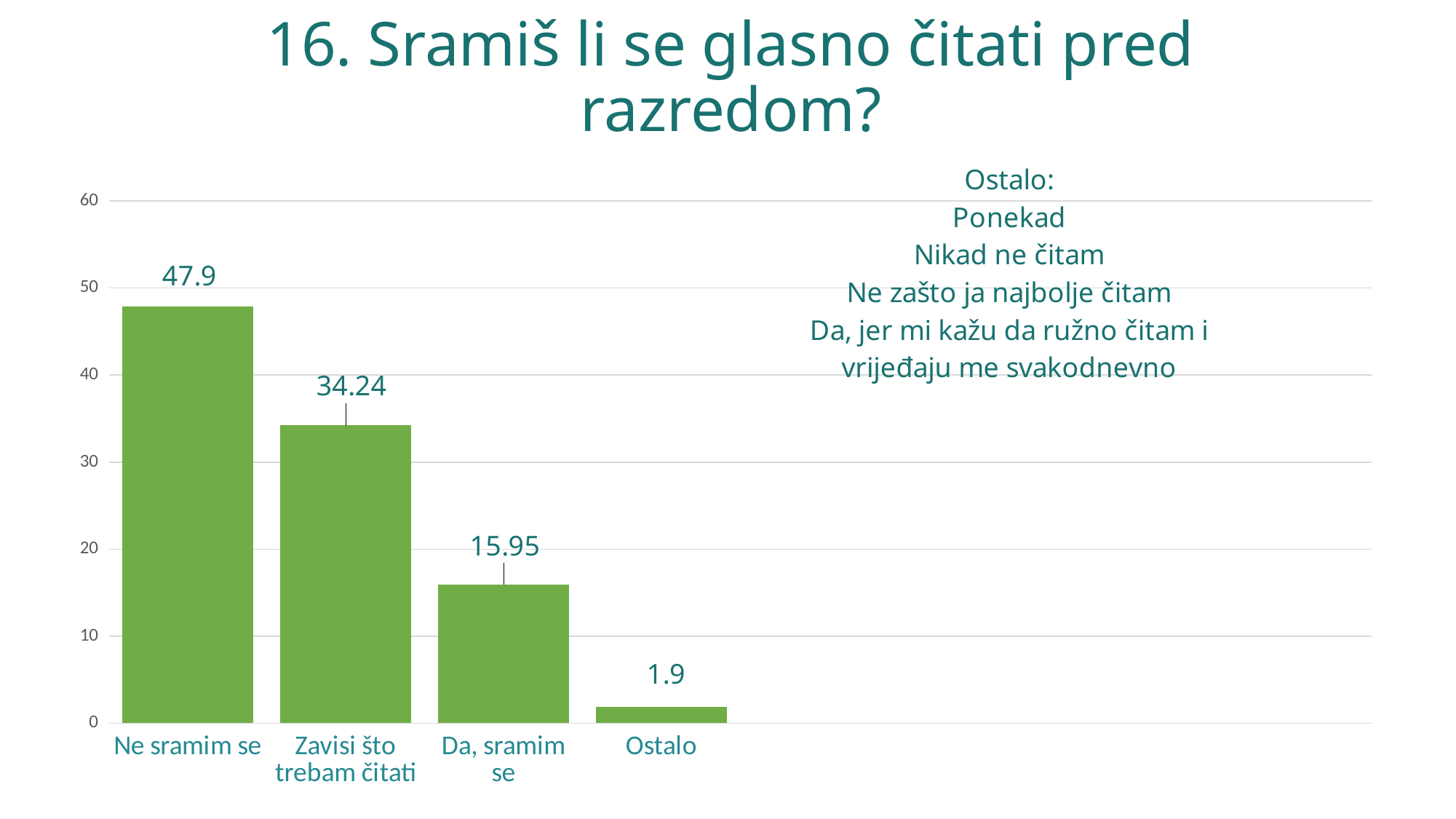
Which is larger, the value for "Da, sramim se" or the value for "Ostalo"? Da, sramim se What is the value for "Ostalo"? 1.9 What is the value for "Ne sramim se"? 47.9 Which category has the highest value? Ne sramim se What is the title of the slide? 16. Sramiš li se glasno čitati pred razredom? Which category has the lowest value? Ostalo What is the value for "Zavisi što trebam čitati"? 34.24 What kind of chart is shown on the slide? bar chart How many categories are shown on the x axis? 4 What is the value for "Da, sramim se"? 15.95 Is the value for "Zavisi što trebam čitati" greater or less than 30? greater What is the difference between the values for "Ne sramim se" and "Zavisi što trebam čitati"? 13.66